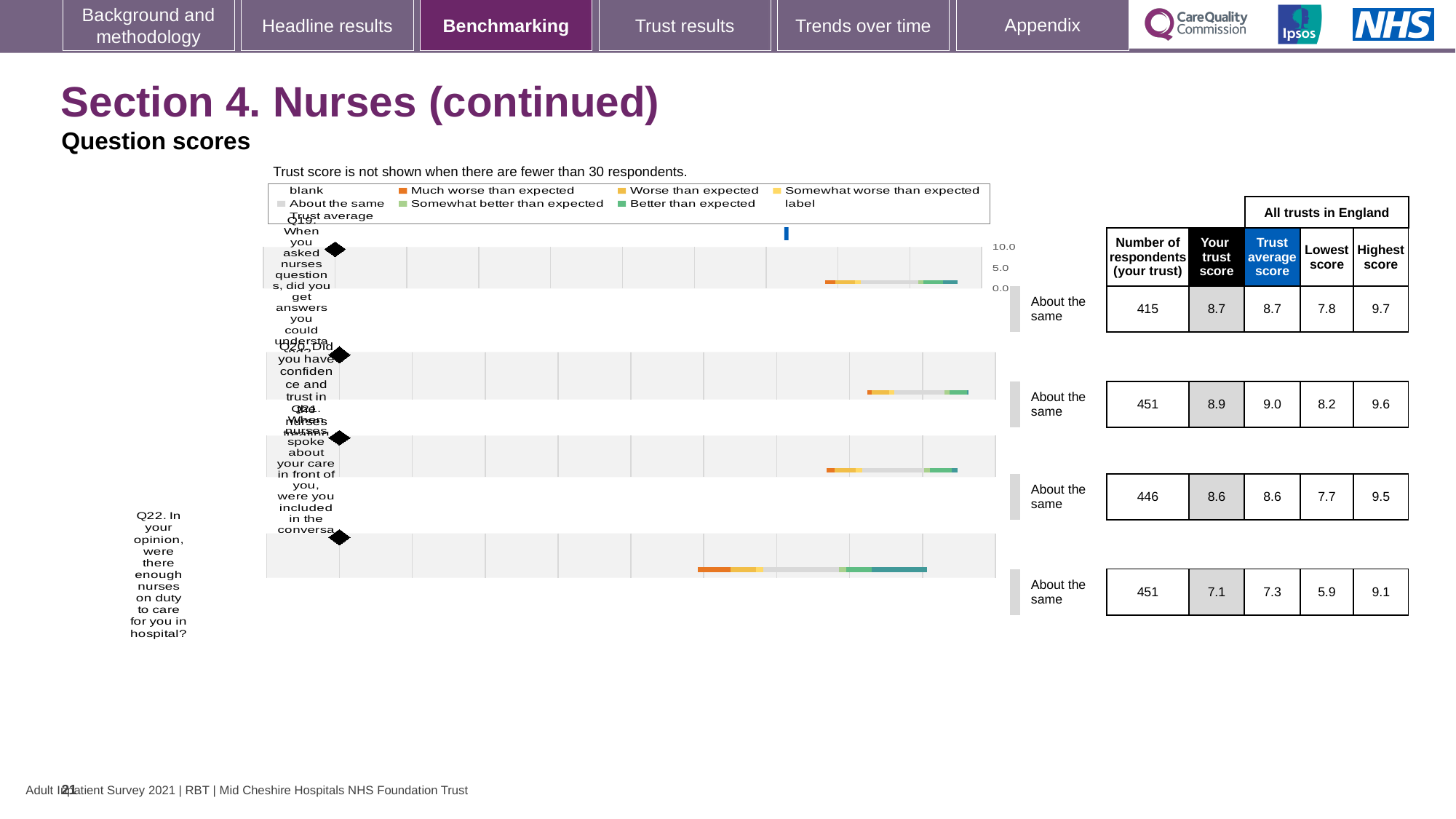
How many questions (Q19 to Q22) are plotted in the chart? 4 How many respondents from your trust answered Q19? 415 Which question has the lowest 'Your trust score'? Q22 What is the difference between the 'Your trust score' for Q20 and for Q22? 1.8 What is the difference between the highest score and the lowest score for Q22? 3.2 What is the 'Lowest score' for Q21 (nurses speaking about your care in front of you)? 7.7 What is the 'Your trust score' for Q22 (enough nurses on duty)? 7.1 For Q22, which is larger: the 'Your trust score' or the 'Trust average score'? Trust average score What is the 'Trust average score' for Q20 (confidence and trust in nurses)? 9.0 What kind of chart is used to show the question scores on this slide? bar chart What benchmark category label is shown next to each of the four questions? About the same Which question has the highest 'Your trust score'? Q20